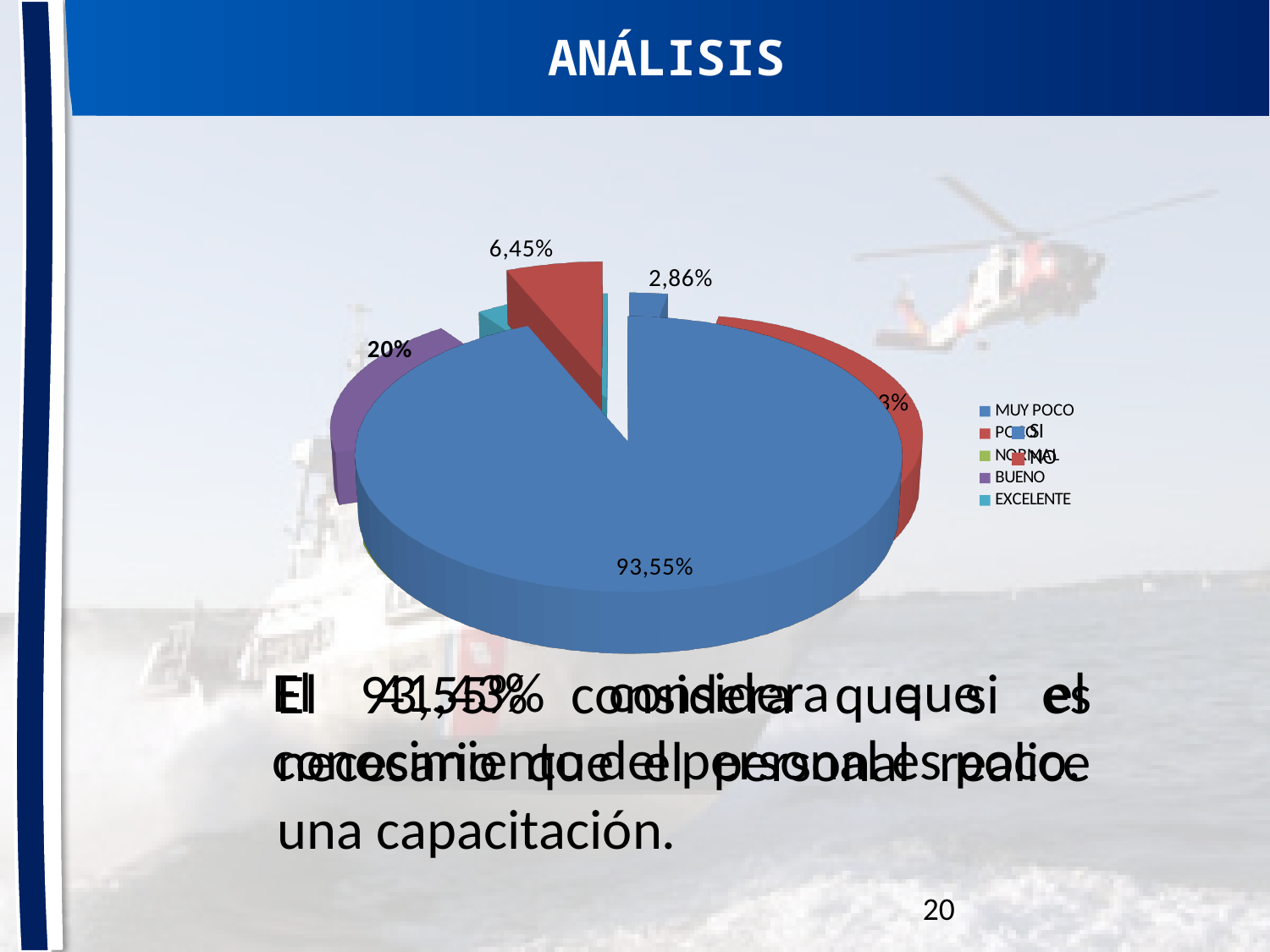
What colour is the largest slice of the pie chart? blue What do the 93,55% slice and the 6,45% slice add up to? 100% What kind of chart is shown on the slide? pie chart What is the difference between the 93,55% slice and the 6,45% slice? 87,10% What percentage is shown on the largest slice of the pie chart? 93,55% What is the title of the slide containing the pie chart? ANÁLISIS Is the largest slice of the pie chart greater or less than 50%? greater Which is larger, the slice labelled 93,55% or the slice labelled 6,45%? 93,55%